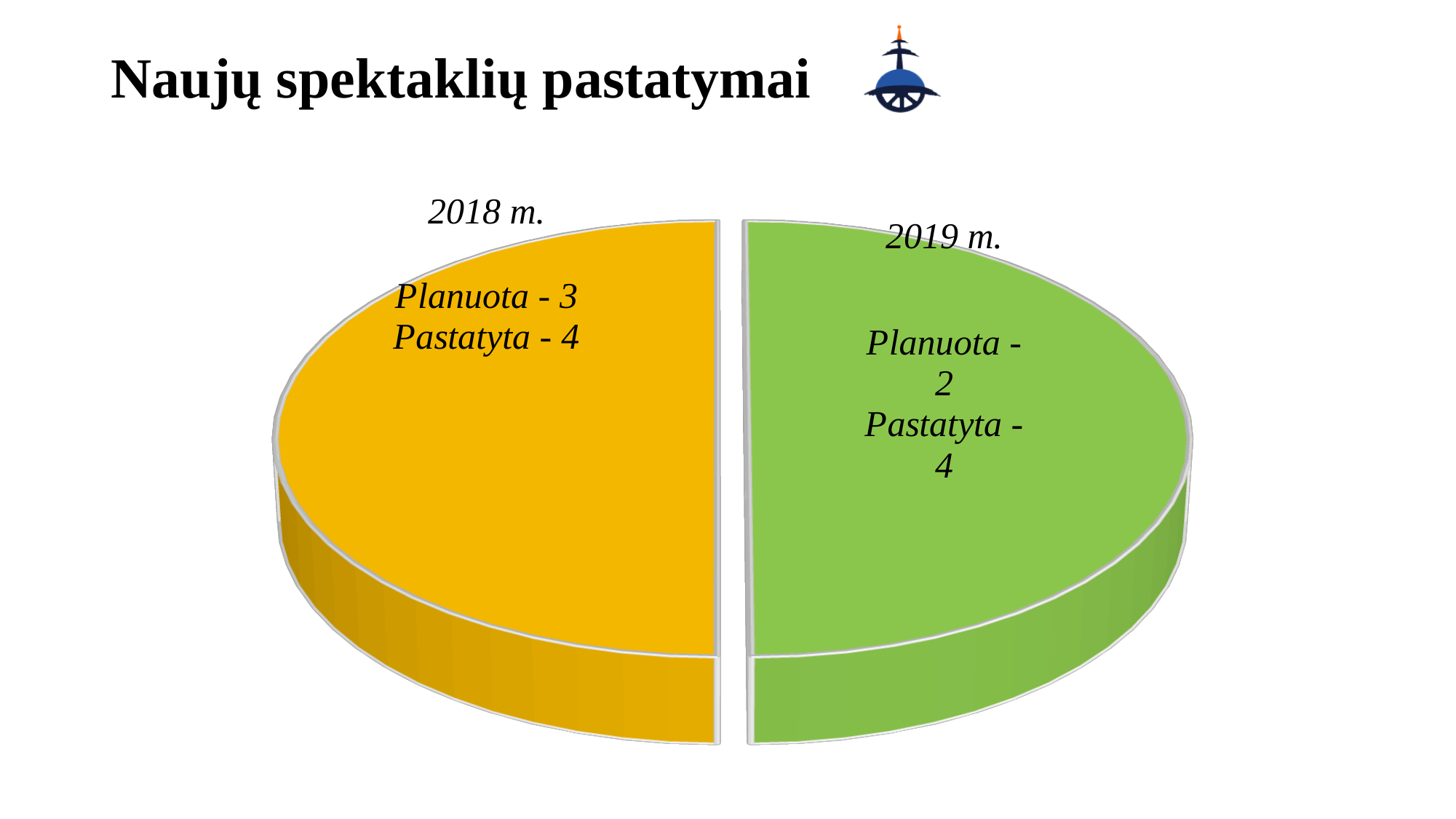
What kind of chart is shown on the slide? pie chart What is the 'Planuota' value shown for 2018 m.? 3 What colour is the slice labelled 2019 m.? green What is the 'Planuota' value shown for 2019 m.? 2 What is the difference between the 'Planuota' values for 2018 m. and 2019 m.? 1 What is the 'Pastatyta' value shown for 2019 m.? 4 For 2019 m., how much larger is 'Pastatyta' than 'Planuota'? 2 What is the title of the slide? Naujų spektaklių pastatymai What is the 'Pastatyta' value shown for 2018 m.? 4 For 2018 m., how much larger is 'Pastatyta' than 'Planuota'? 1 How many slices does the pie chart have? 2 Which year has the higher 'Planuota' value, 2018 m. or 2019 m.? 2018 m.